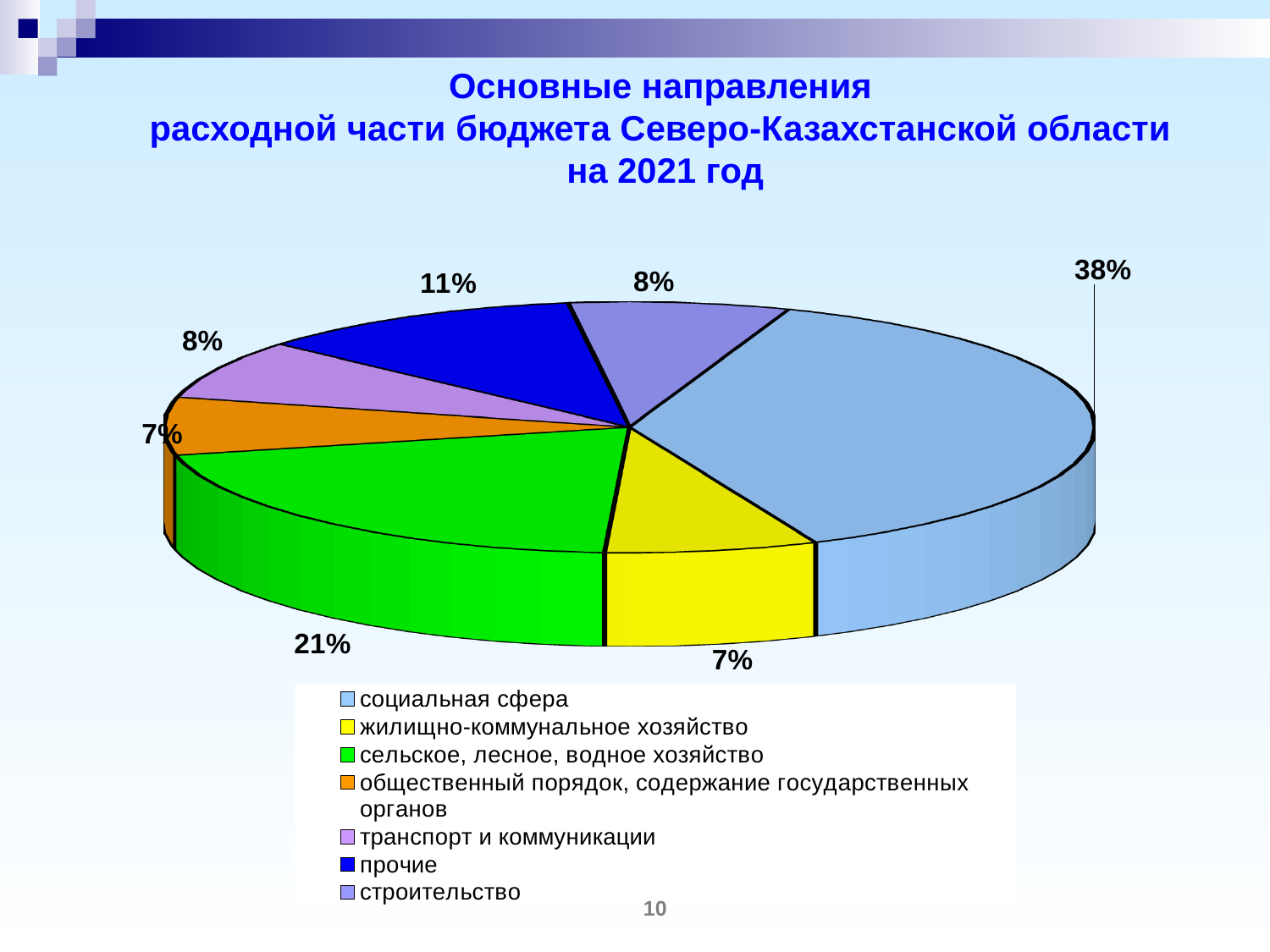
What is the value for сельское, лесное, водное хозяйство? 21% What share of the pie does социальная сфера have? 38% What kind of chart is shown on the slide? pie chart How many entries does the legend list? 7 What is the value for прочие? 11% What colour is the slice for сельское, лесное, водное хозяйство? green What is the value for жилищно-коммунальное хозяйство? 7% Which category has the largest share of the pie? социальная сфера What is the difference between the shares of социальная сфера and сельское, лесное, водное хозяйство? 17% Which is larger, прочие or транспорт и коммуникации? прочие How many slices does the pie chart have? 7 What is the value for строительство? 8%